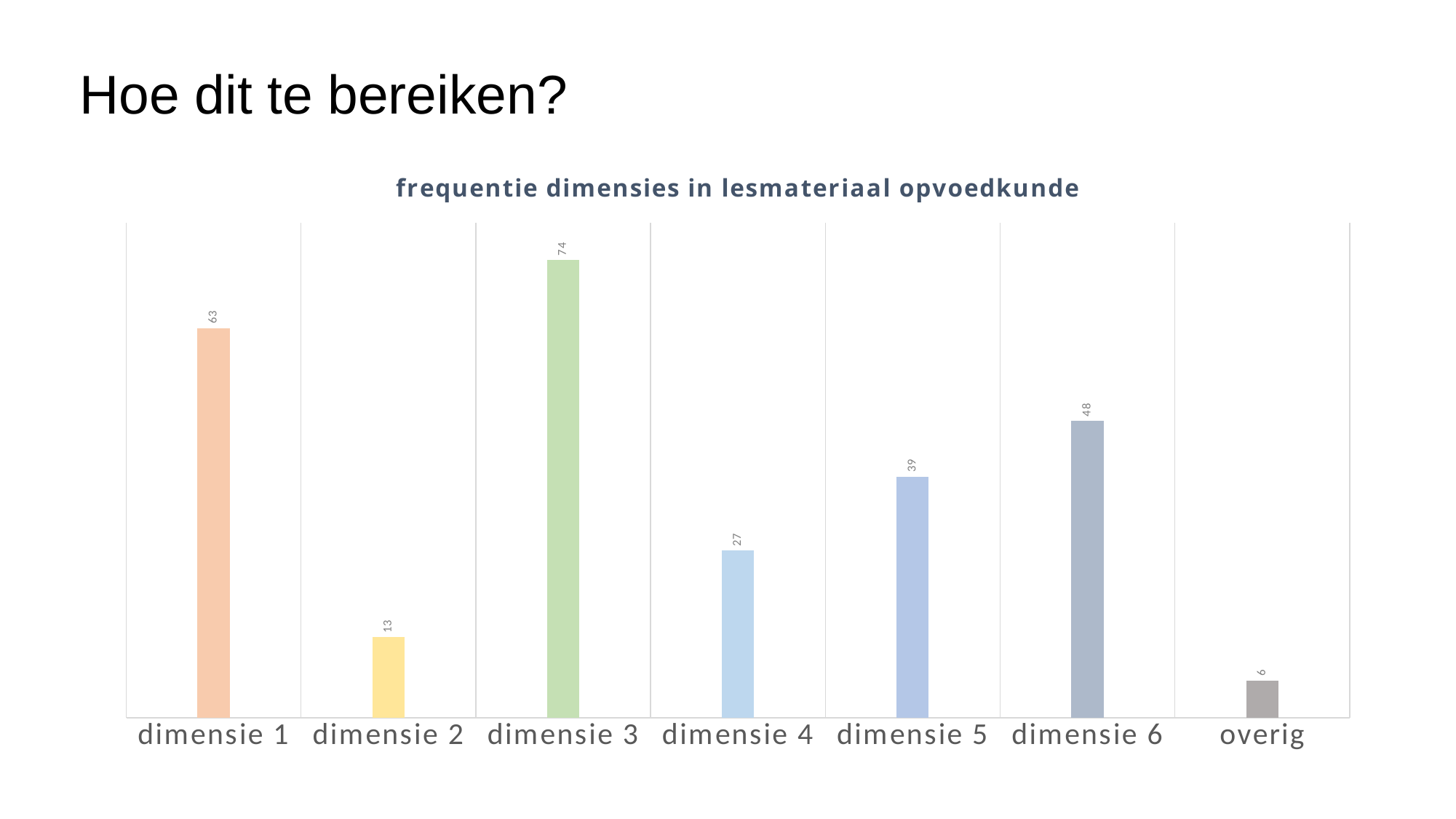
Which category has the lowest value? overig What is the difference between the values for dimensie 6 and dimensie 4? 21 Which category has the highest value? dimensie 3 What is the title of the chart? frequentie dimensies in lesmateriaal opvoedkunde What kind of chart is shown on the slide? bar chart What is the value for dimensie 1? 63 Which is larger, the value for dimensie 2 or the value for dimensie 4? dimensie 4 What is the value for dimensie 3? 74 How many categories are shown on the x axis? 7 What is the value for overig? 6 What is the value for dimensie 5? 39 What is the difference between the values for dimensie 3 and dimensie 1? 11